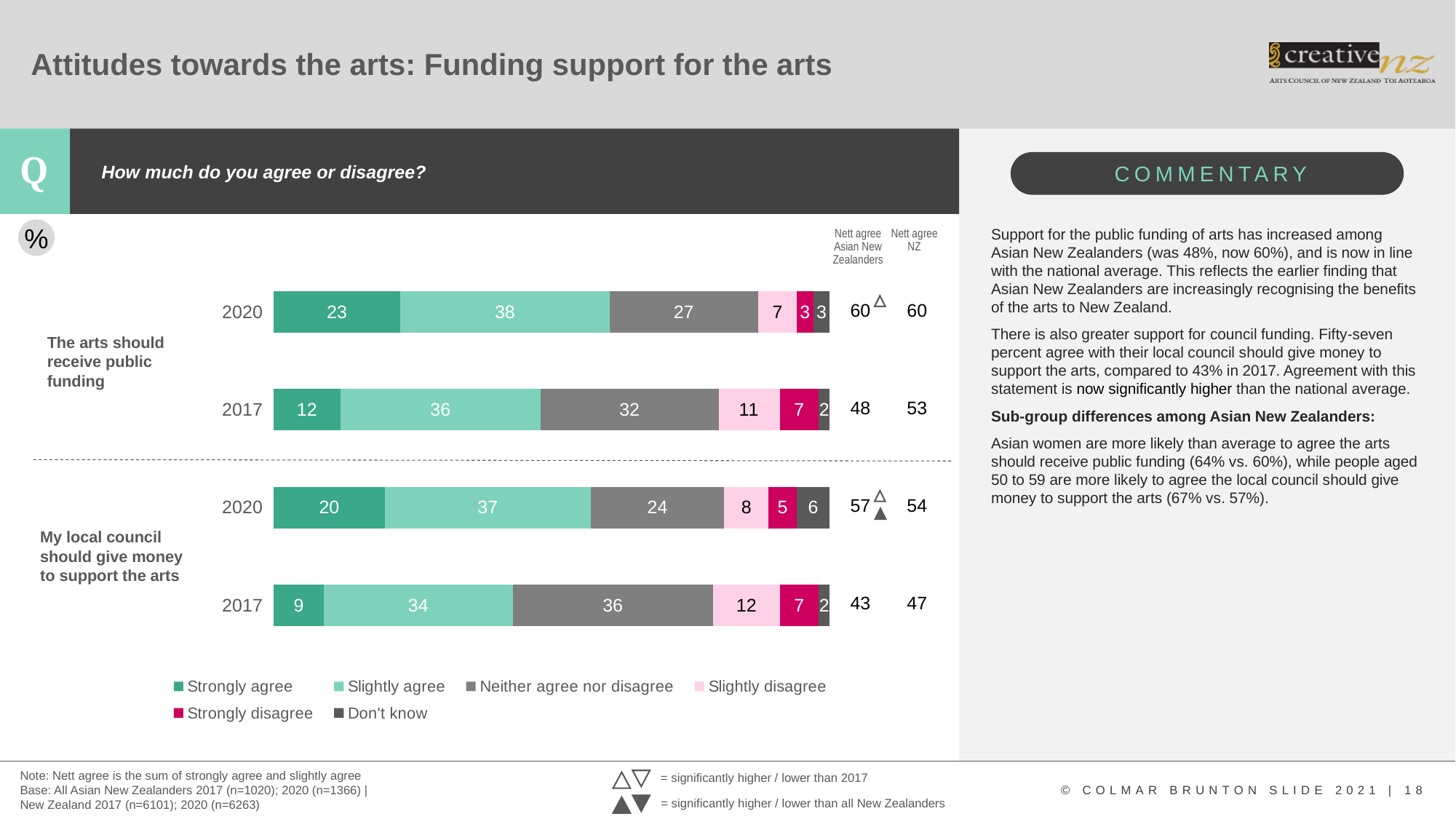
What is the Nett agree figure for Asian New Zealanders for 'My local council should give money to support the arts' in 2020? 57 Is the 'Strongly disagree' value larger for 'The arts should receive public funding' in 2020 or in 2017? 2017 What is the 'Strongly agree' value for 'The arts should receive public funding' in 2020? 23 What kind of chart is shown on the slide? Stacked bar chart What is the 'Neither agree nor disagree' value for 'My local council should give money to support the arts' in 2017? 36 Which bar has the highest 'Strongly agree' value? The arts should receive public funding, 2020 Which bar has the lowest 'Strongly agree' value? My local council should give money to support the arts, 2017 How many bars are plotted in the chart? 4 How many series does the legend list? 6 What is the 'Slightly disagree' value for 'The arts should receive public funding' in 2017? 11 What is the difference between the 'Slightly agree' values for 'The arts should receive public funding' in 2020 and 2017? 2